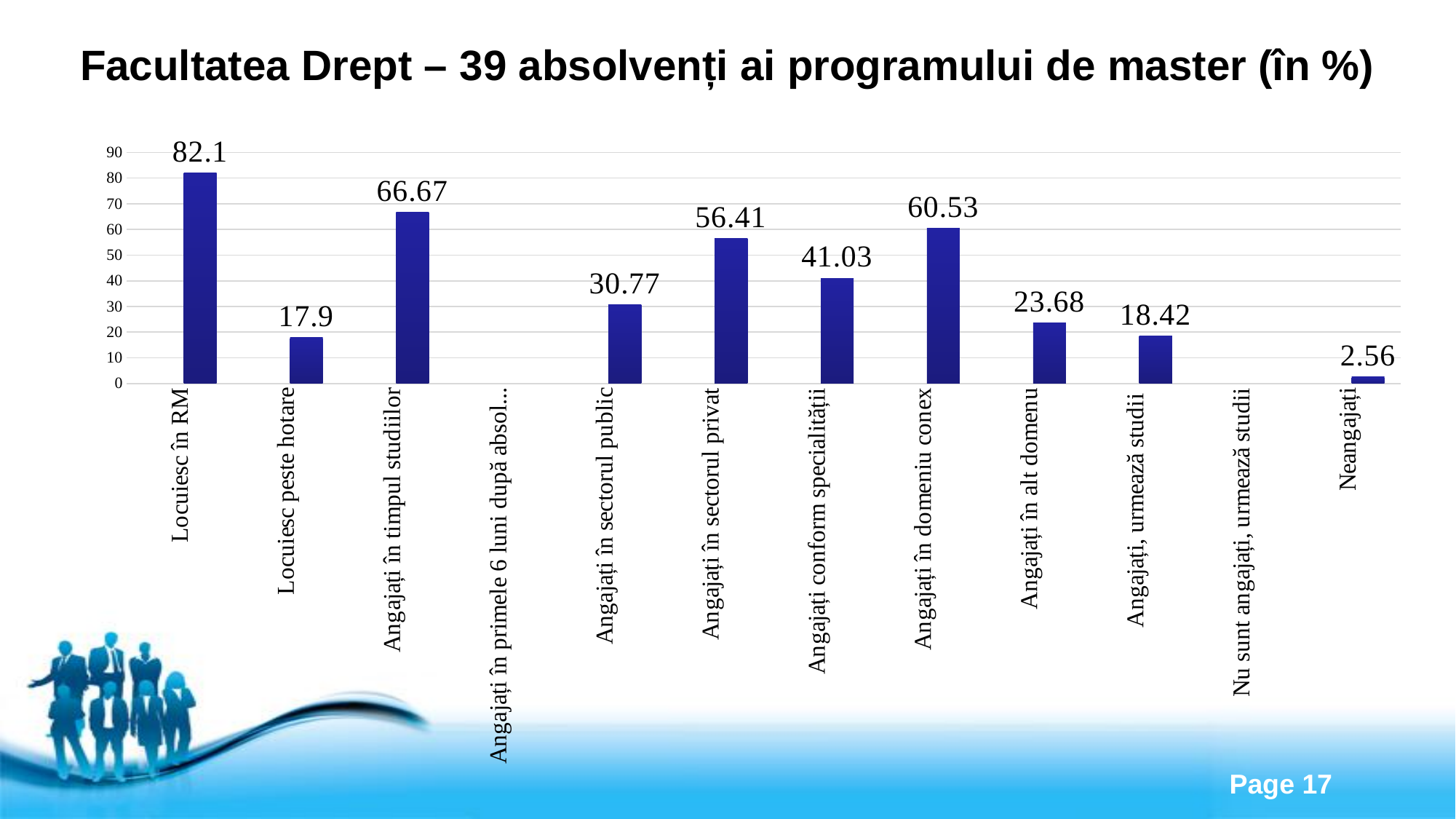
What is the value for "Locuiesc în RM"? 82.1 Which category has the highest value? Locuiesc în RM Which is larger, the value for "Angajați în domeniu conex" or the value for "Angajați în sectorul privat"? Angajați în domeniu conex What is the value for "Neangajați"? 2.56 Is the value for "Angajați conform specialității" greater or less than 50? less How many categories are listed on the x axis? 12 What is the title of the slide? Facultatea Drept – 39 absolvenți ai programului de master (în %) What is the value for "Angajați în sectorul privat"? 56.41 Which category with a plotted bar has the lowest value? Neangajați What is the value for "Angajați, urmează studii"? 18.42 What kind of chart is shown on the slide? bar chart What is the difference between the values for "Locuiesc în RM" and "Locuiesc peste hotare"? 64.2